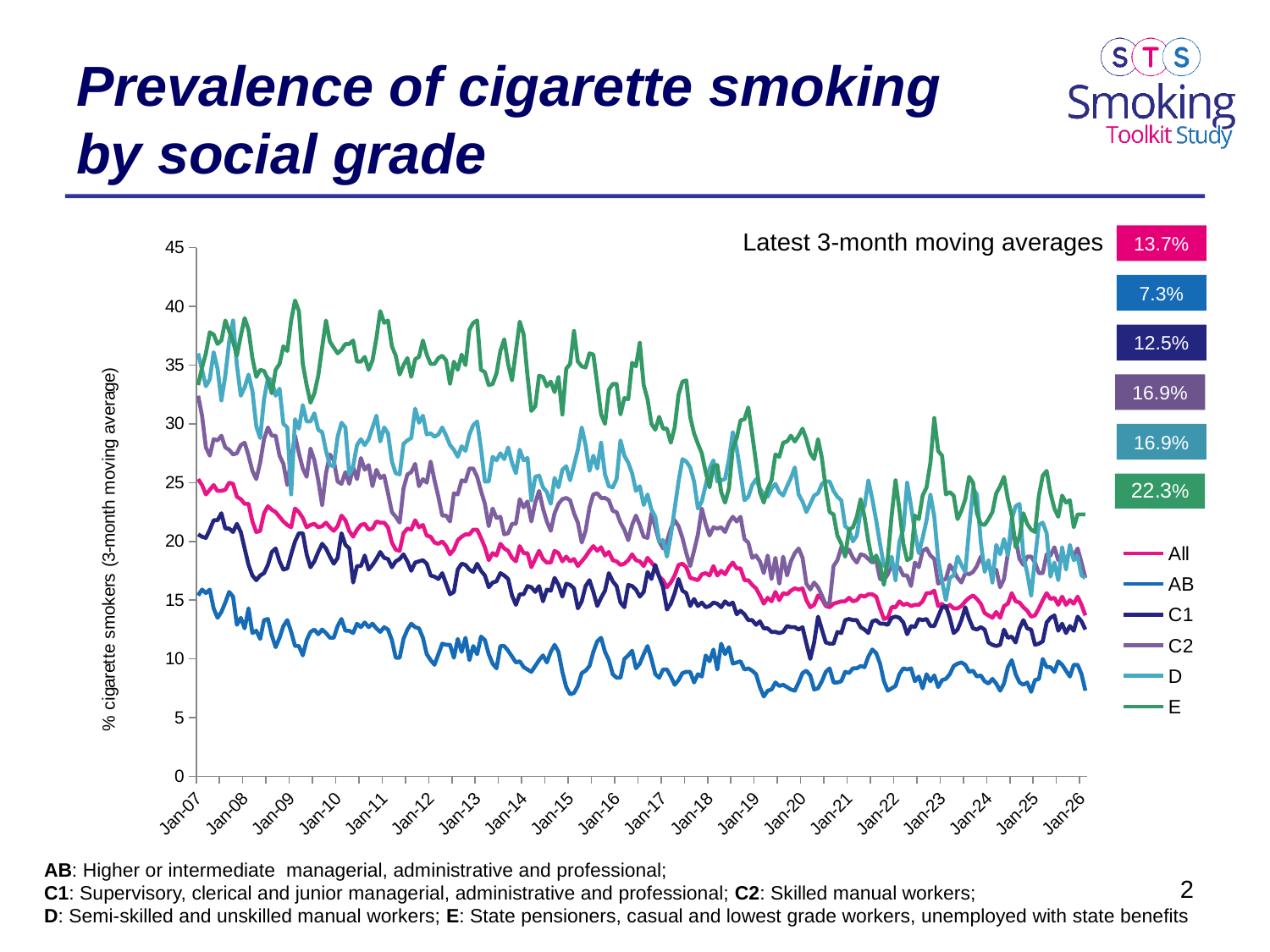
What is the latest 3-month moving average for social grade E? 22.3% What is the latest 3-month moving average for social grade AB? 7.3% Does the prevalence of cigarette smoking for grade E rise or fall from Jan-07 to Jan-26? fall What is the latest 3-month moving average for All smokers? 13.7% How many series does the legend list? 6 What is the latest 3-month moving average for social grade C1? 12.5% What is the difference between the latest 3-month moving averages for grade E and grade AB? 15.0% Is the value for grade AB at Jan-07 greater or less than 10? greater Is the latest 3-month moving average for grade C2 larger or smaller than that for grade C1? larger Which social grade has the lowest latest 3-month moving average? AB Which social grade has the highest latest 3-month moving average? E What kind of chart is shown on the slide? line chart